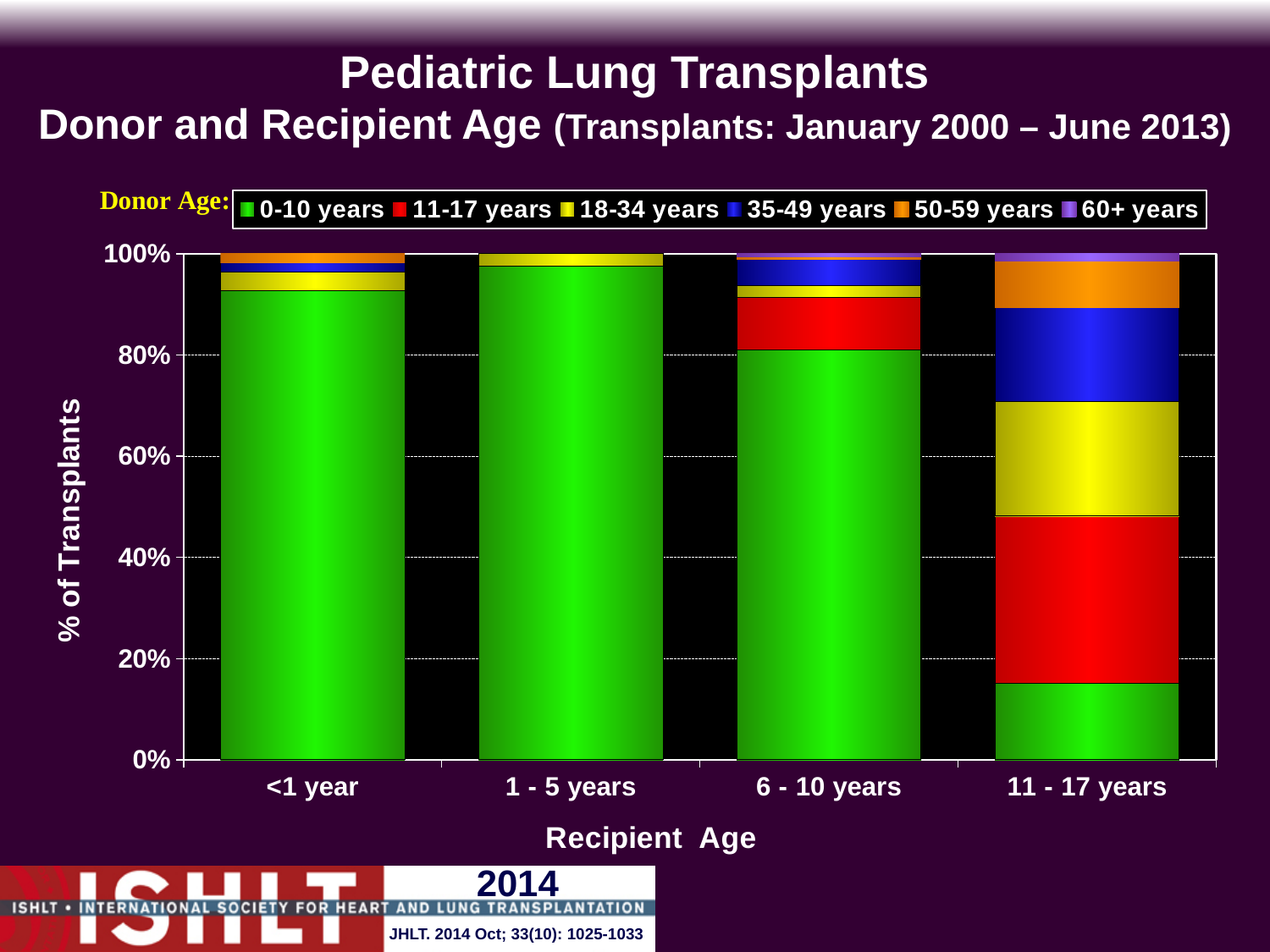
How many recipient age categories are shown on the x axis? 4 Which recipient age group has the smallest share of transplants from donors aged 0-10 years? 11 - 17 years Which recipient age group has the largest share of transplants from donors aged 0-10 years? 1 - 5 years Is the share of transplants from donors aged 11-17 years for recipients aged 11 - 17 years greater or less than 20%? greater Which has a larger share of transplants from donors aged 0-10 years: recipients aged <1 year or recipients aged 11 - 17 years? <1 year What is the total of each stacked bar in the chart? 100% Does the share of transplants from donors aged 0-10 years rise or fall from the 1 - 5 years recipient group to the 11 - 17 years recipient group? fall What is the label of the y axis? % of Transplants How many donor age groups does the legend list? 6 What kind of chart is shown on the slide? Stacked bar chart Is the share of transplants from donors aged 0-10 years for recipients aged 11 - 17 years greater or less than 20%? less